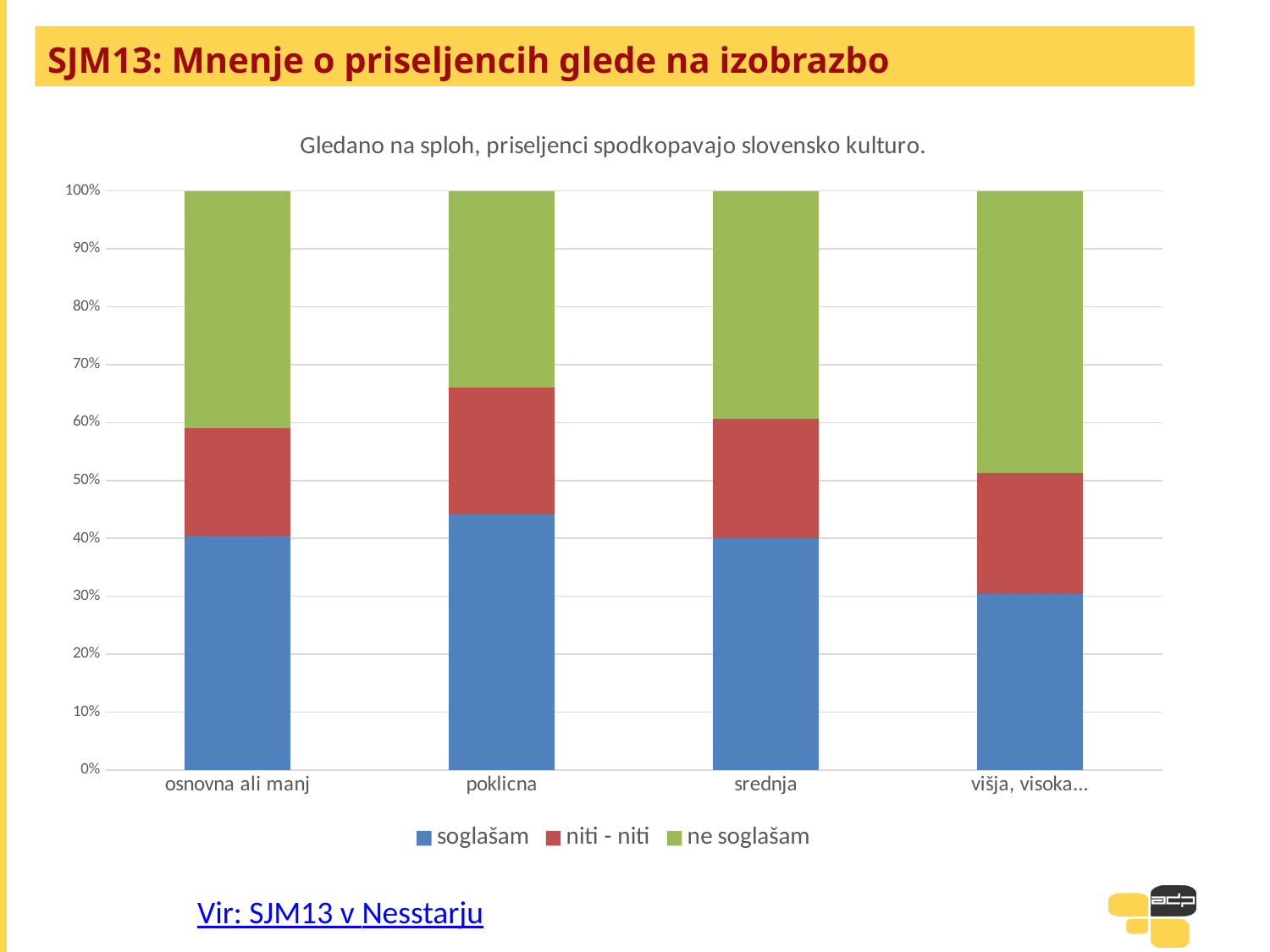
What statement is given as the chart title? Gledano na sploh, priseljenci spodkopavajo slovensko kulturo. Is the 'soglašam' share for 'višja, visoka...' greater or less than 40%? less Which education category has the largest 'soglašam' share? poklicna How many series does the legend list? 3 Which education category has the smallest 'soglašam' share? višja, visoka... Which has a larger 'soglašam' share: 'osnovna ali manj' or 'višja, visoka...'? osnovna ali manj Which education category has the smallest 'ne soglašam' share? poklicna Which education category has the largest 'ne soglašam' share? višja, visoka... What is the total height of each stacked bar? 100% What kind of chart is shown on the slide? stacked bar chart Is the 'soglašam' share for 'poklicna' greater or less than 40%? greater How many education categories are shown on the x axis? 4